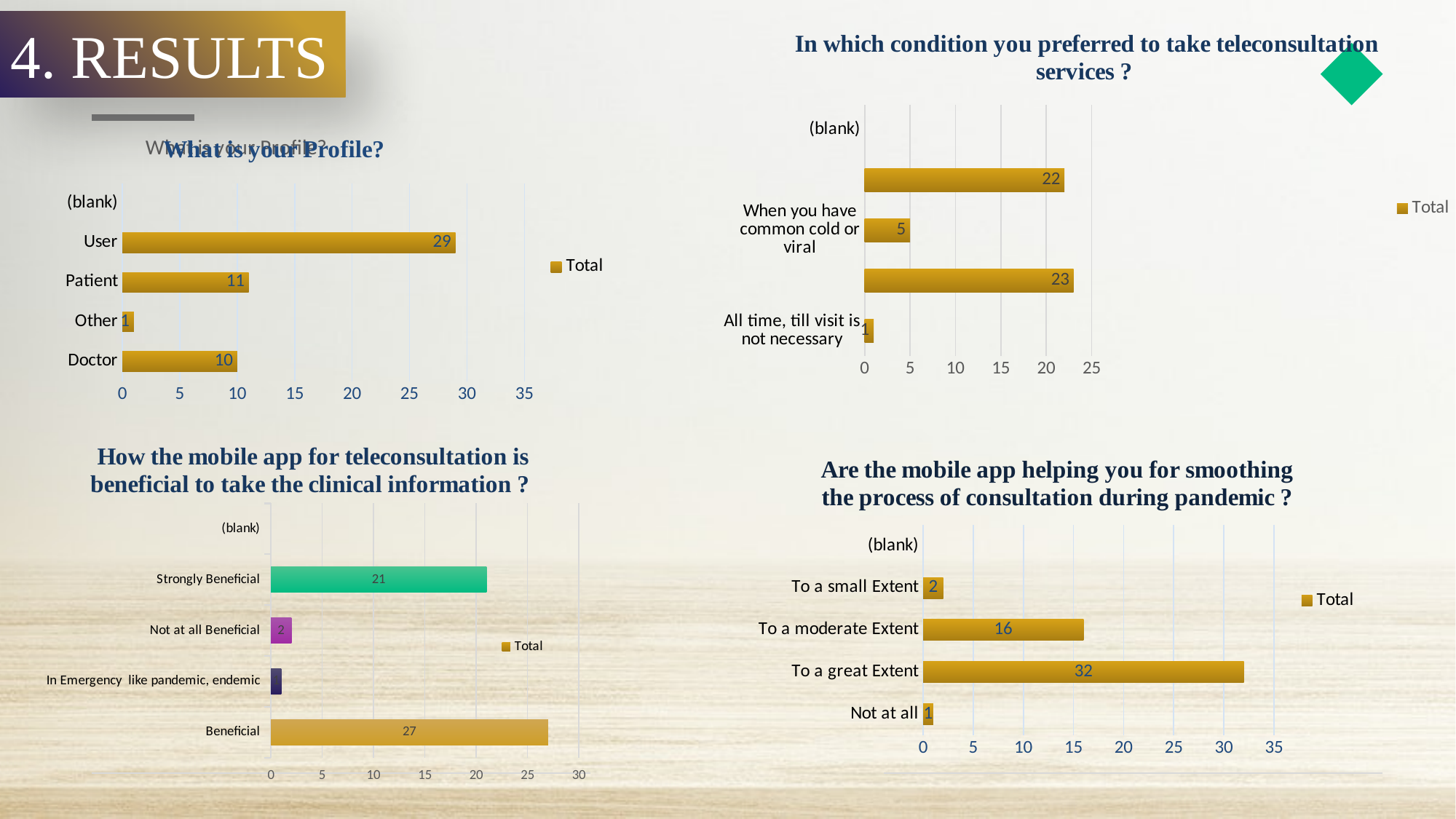
In the 'What is your Profile?' chart, what is the value for User? 29 What kind of chart is the 'What is your Profile?' chart? Bar chart In the 'How the mobile app for teleconsultation is beneficial to take the clinical information?' chart, which is larger: Strongly Beneficial or Beneficial? Beneficial In the 'What is your Profile?' chart, which category has the highest value? User In the 'How the mobile app for teleconsultation is beneficial to take the clinical information?' chart, what is the value for Beneficial? 27 In the 'Are the mobile app helping you for smoothing the process of consultation during pandemic?' chart, what is the difference between 'To a great Extent' and 'To a moderate Extent'? 16 In the 'What is your Profile?' chart, what is the value for Other? 1 In the 'What is your Profile?' chart, what is the difference between the values for Patient and Doctor? 1 In the 'In which condition you preferred to take teleconsultation services?' chart, what is the value for 'When you have common cold or viral'? 5 In the 'In which condition you preferred to take teleconsultation services?' chart, what is the value for 'All time, till visit is not necessary'? 1 In the 'Are the mobile app helping you for smoothing the process of consultation during pandemic?' chart, what is the value for 'To a great Extent'? 32 In the 'How the mobile app for teleconsultation is beneficial to take the clinical information?' chart, is the value for 'In Emergency like pandemic, endemic' greater or less than 5? less